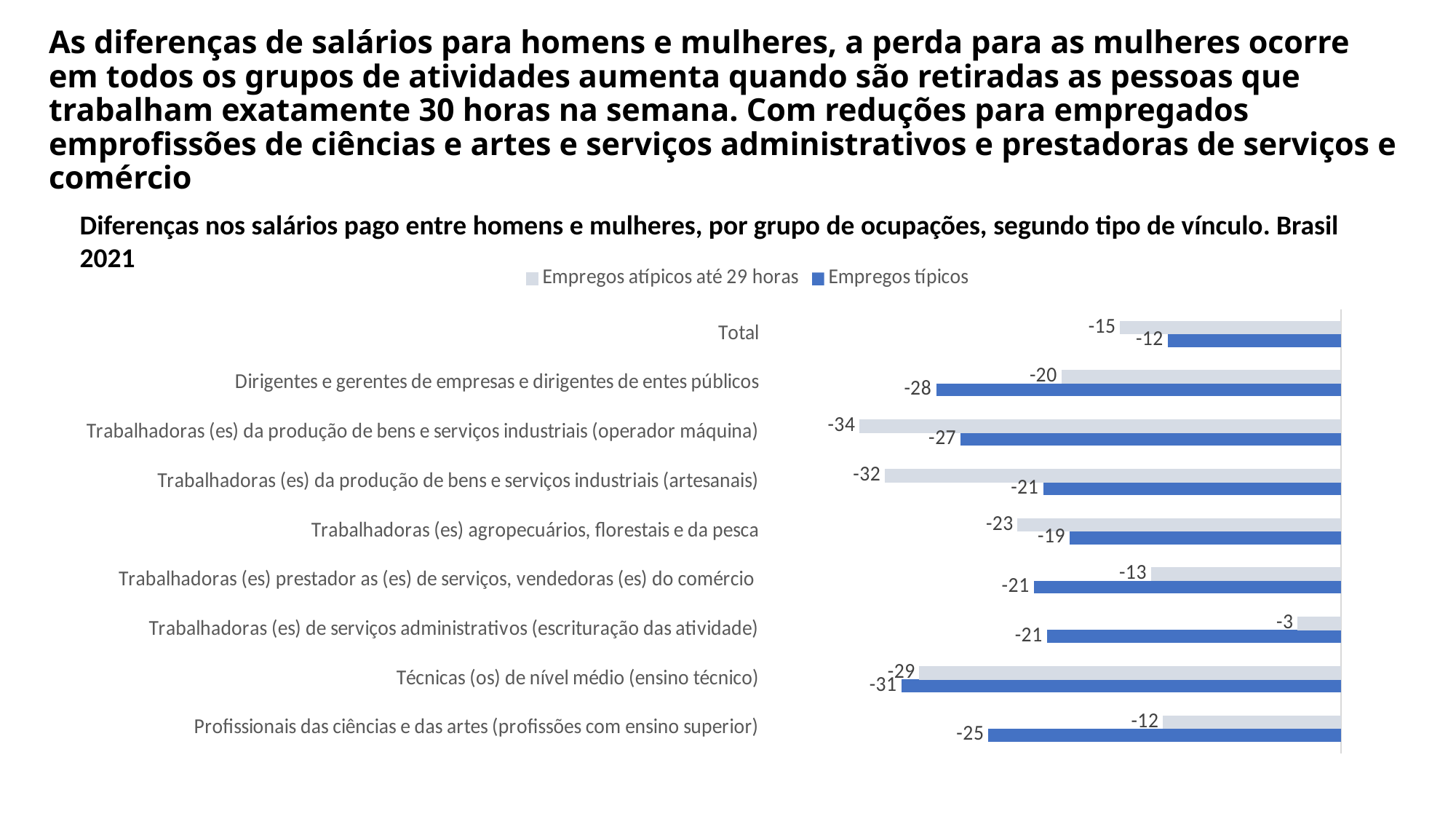
Which colour represents the 'Empregos típicos' series in the chart? Blue What is the difference between the 'Empregos atípicos até 29 horas' value (-34) and the 'Empregos típicos' value (-27) for 'Trabalhadoras (es) da produção de bens e serviços industriais (operador máquina)'? 7 What is the value for 'Empregos atípicos até 29 horas' for 'Profissionais das ciências e das artes (profissões com ensino superior)'? -12 Which category has the lowest (most negative) value for 'Empregos atípicos até 29 horas'? Trabalhadoras (es) da produção de bens e serviços industriais (operador máquina) What is the value for 'Empregos típicos' for 'Técnicas (os) de nível médio (ensino técnico)'? -31 How many occupation groups (categories) are plotted in the chart, including Total? 9 For 'Dirigentes e gerentes de empresas e dirigentes de entes públicos', which series has the more negative value: 'Empregos atípicos até 29 horas' or 'Empregos típicos'? Empregos típicos Which category has the lowest (most negative) value for 'Empregos típicos'? Técnicas (os) de nível médio (ensino técnico) How many series does the legend list? 2 What is the value for 'Empregos atípicos até 29 horas' for 'Trabalhadoras (es) de serviços administrativos (escrituração das atividade)'? -3 What kind of chart is shown on the slide? Bar chart What is the value for 'Empregos típicos' in the Total category? -12